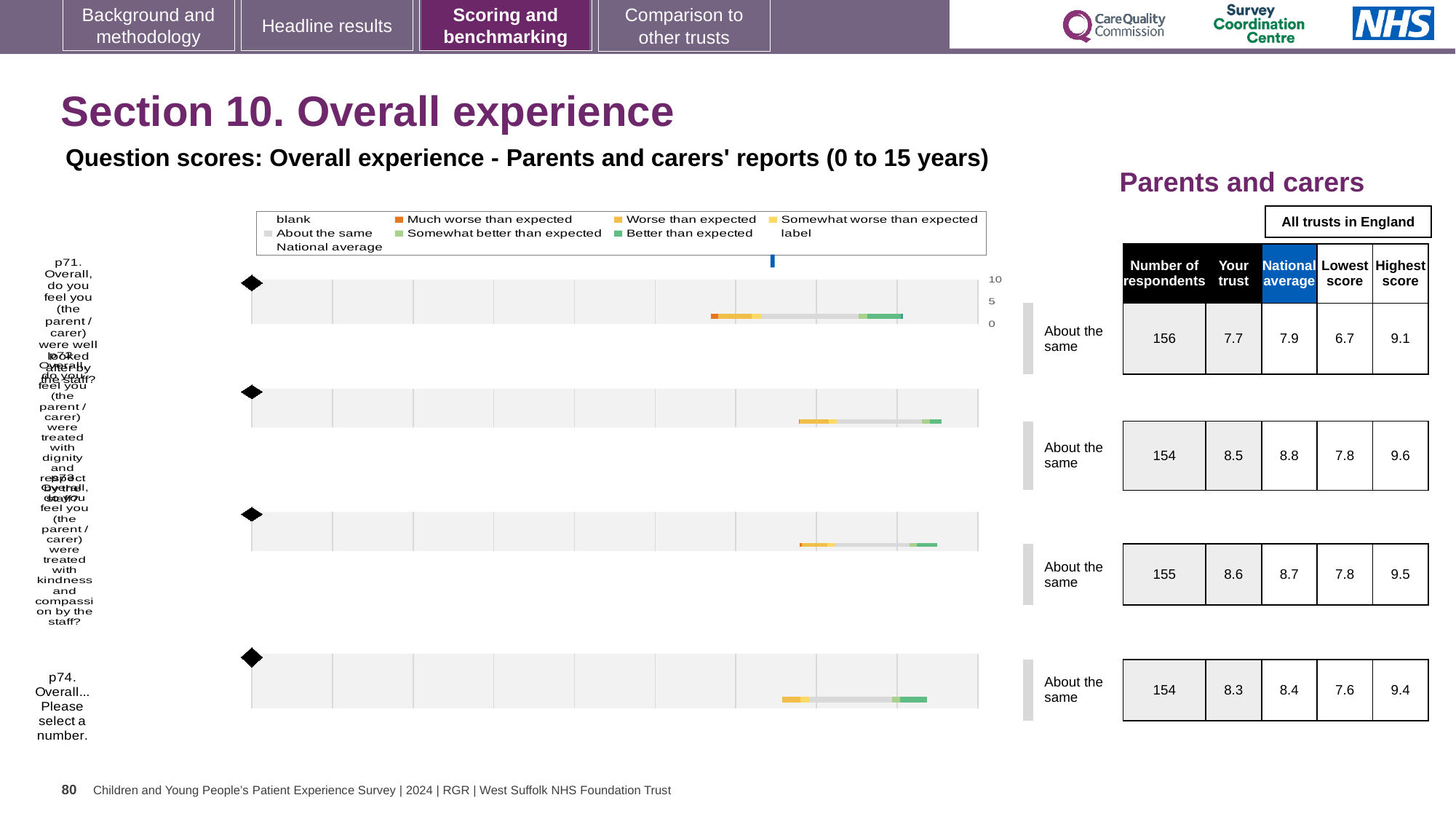
In the table beside the chart, is the 'Your trust' score for the last row (p74) larger or smaller than the National average? smaller In the table beside the chart, what is the 'Your trust' score for the first row (p71)? 7.7 What is the label of the bottom bar in the chart? p74. Overall... Please select a number. How many horizontal bars are plotted in the chart? 4 In the table beside the chart, what is the Highest score for the last row (p74)? 9.4 In the table beside the chart, what is the number of respondents for the first row (p71)? 156 In the table beside the chart, what is the National average for the last row (p74)? 8.4 What kind of chart is shown on the slide? bar chart What is the highest tick value shown on the chart's axis? 10 In the table beside the chart, which row has the highest 'Your trust' score? the third row (8.6) How many entries does the chart legend list? 9 In the table beside the chart, what is the difference between the National average and 'Your trust' score for the first row (p71)? 0.2